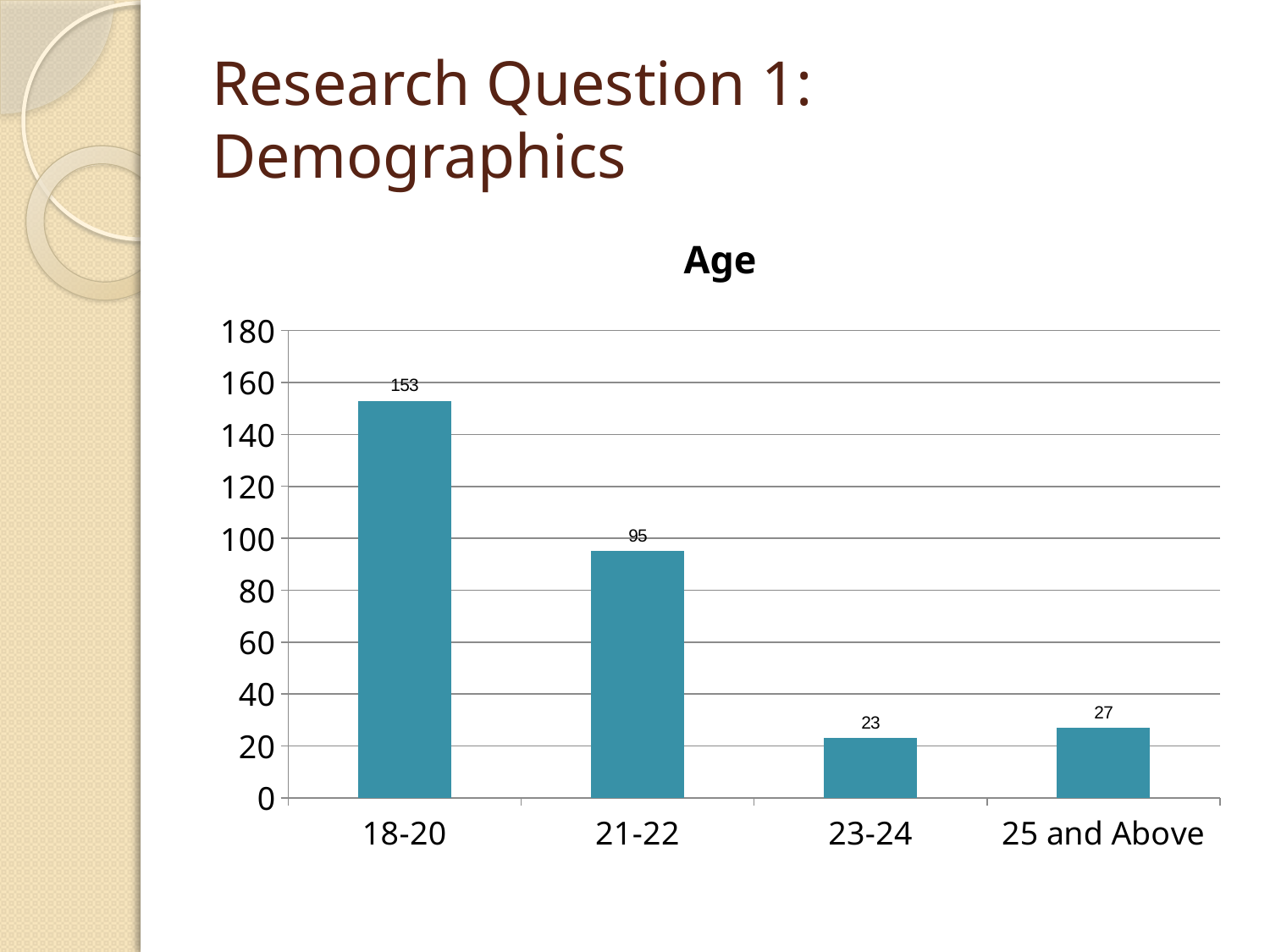
Which age group has the lowest value? 23-24 What is the value for the 25 and Above age group? 27 Which is larger, the value for 23-24 or the value for 25 and Above? 25 and Above What is the title of the chart? Age What is the difference between the values for 18-20 and 21-22? 58 What is the value for the 21-22 age group? 95 How many age groups are shown on the chart? 4 What is the value for the 18-20 age group? 153 Which age group has the highest value? 18-20 Is the value for 21-22 greater or less than 100? less What kind of chart is shown on the slide? bar chart What is the value for the 23-24 age group? 23